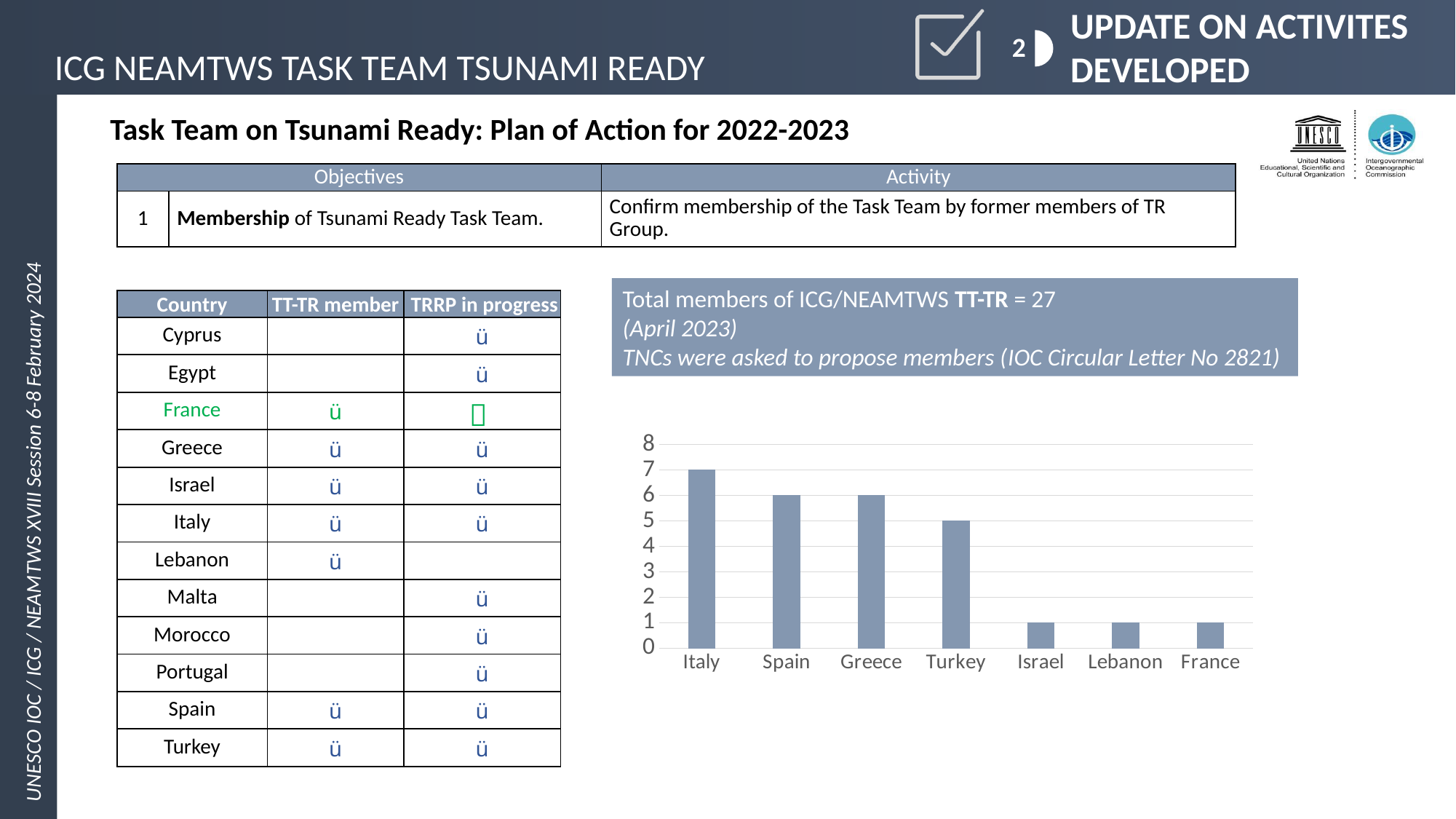
What is the highest value shown on the y axis of the chart? 8 What is the value of the bar for Spain? 6 Which country has the highest bar in the chart? Italy What kind of chart is shown on the slide? bar chart How many countries are shown on the x axis of the bar chart? 7 Is the value for Lebanon greater or less than 3? less What is the value of the bar for Turkey? 5 What is the difference between the bar for Italy and the bar for Turkey? 2 What is the value of the bar for Italy? 7 Which is larger, the bar for Greece or the bar for Turkey? Greece Is the value for Spain greater or less than 4? greater What is the value of the bar for France? 1